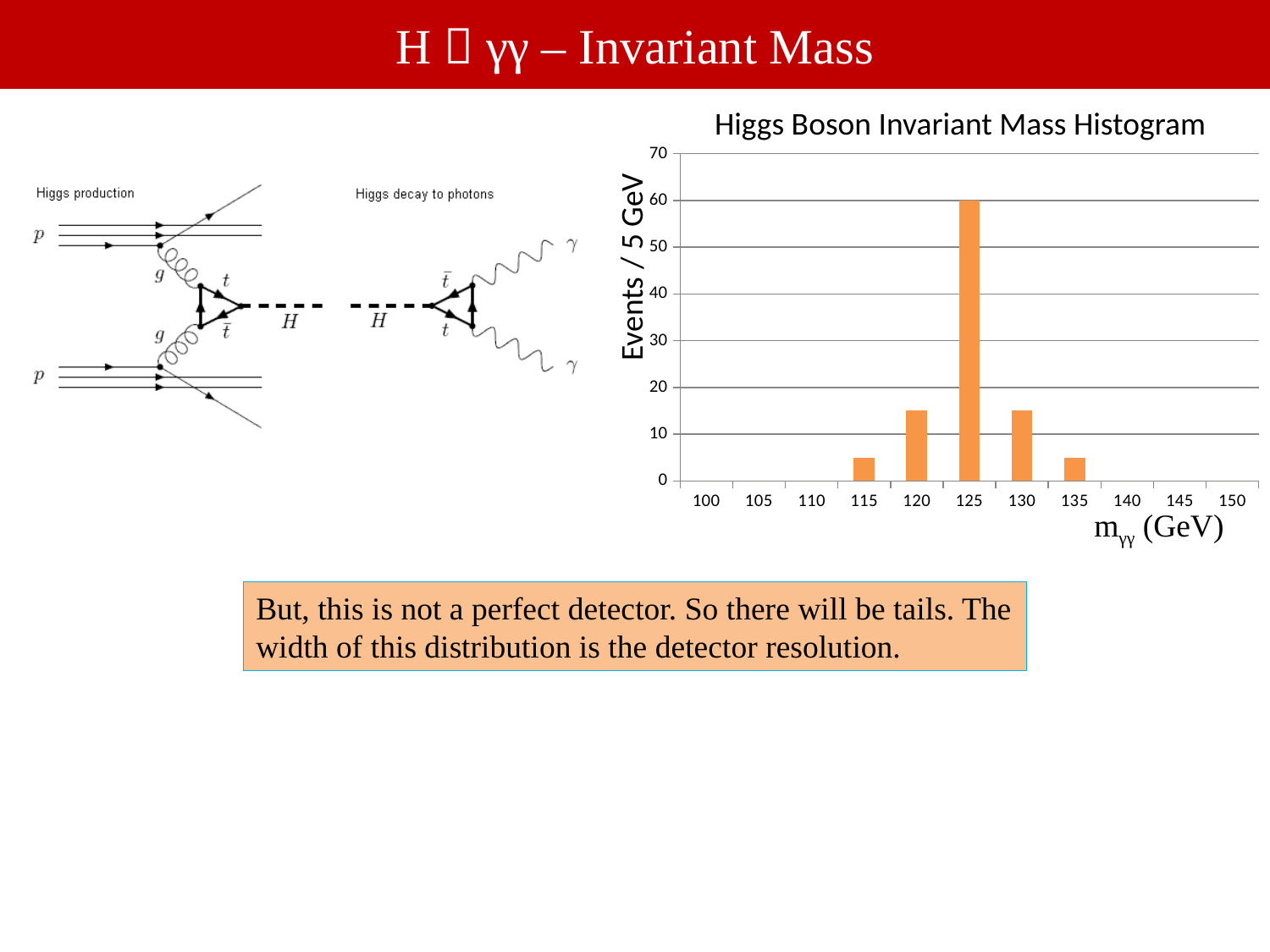
Is the value for the 120 GeV bin greater or less than 10? greater What kind of chart is the Higgs Boson Invariant Mass Histogram? bar chart Is the value for the 135 GeV bin greater or less than 10? less How many mass bins are labelled on the x axis of the histogram? 11 Is the value for the 115 GeV bin greater or less than 10? less What is the label of the y axis of the histogram? Events / 5 GeV Which bin has more events, 125 GeV or 130 GeV? 125 GeV How many mass bins have a visible (non-zero) bar in the histogram? 5 Which mass bin has the highest number of events in the Higgs Boson Invariant Mass Histogram? 125 How many events per 5 GeV are shown for the 125 GeV bin? 60